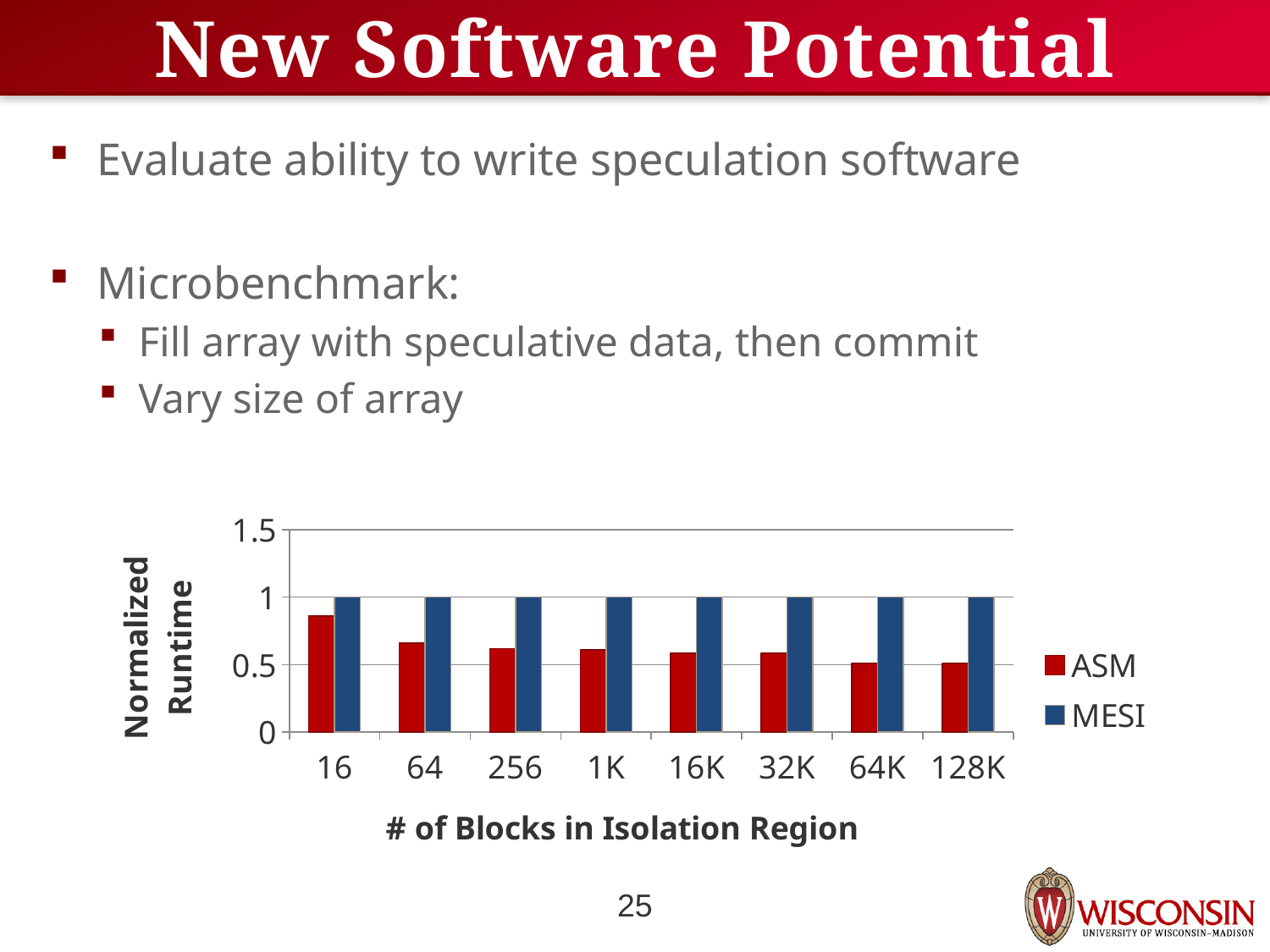
What is the title of the x axis? # of Blocks in Isolation Region Do the ASM values rise or fall as the number of blocks increases along the x axis? fall Is the ASM value for 16 blocks greater or less than 0.5? greater Which category has the highest ASM value? 16 What is the MESI value for 128K blocks? 1 What is the MESI value for 16 blocks? 1 Is the ASM value for 128K blocks greater or less than 1? less How many series does the legend list? 2 For 256 blocks, which series has the larger value, ASM or MESI? MESI How many categories are shown on the x axis? 8 Which colour represents the ASM series? red What kind of chart is shown on the slide? bar chart